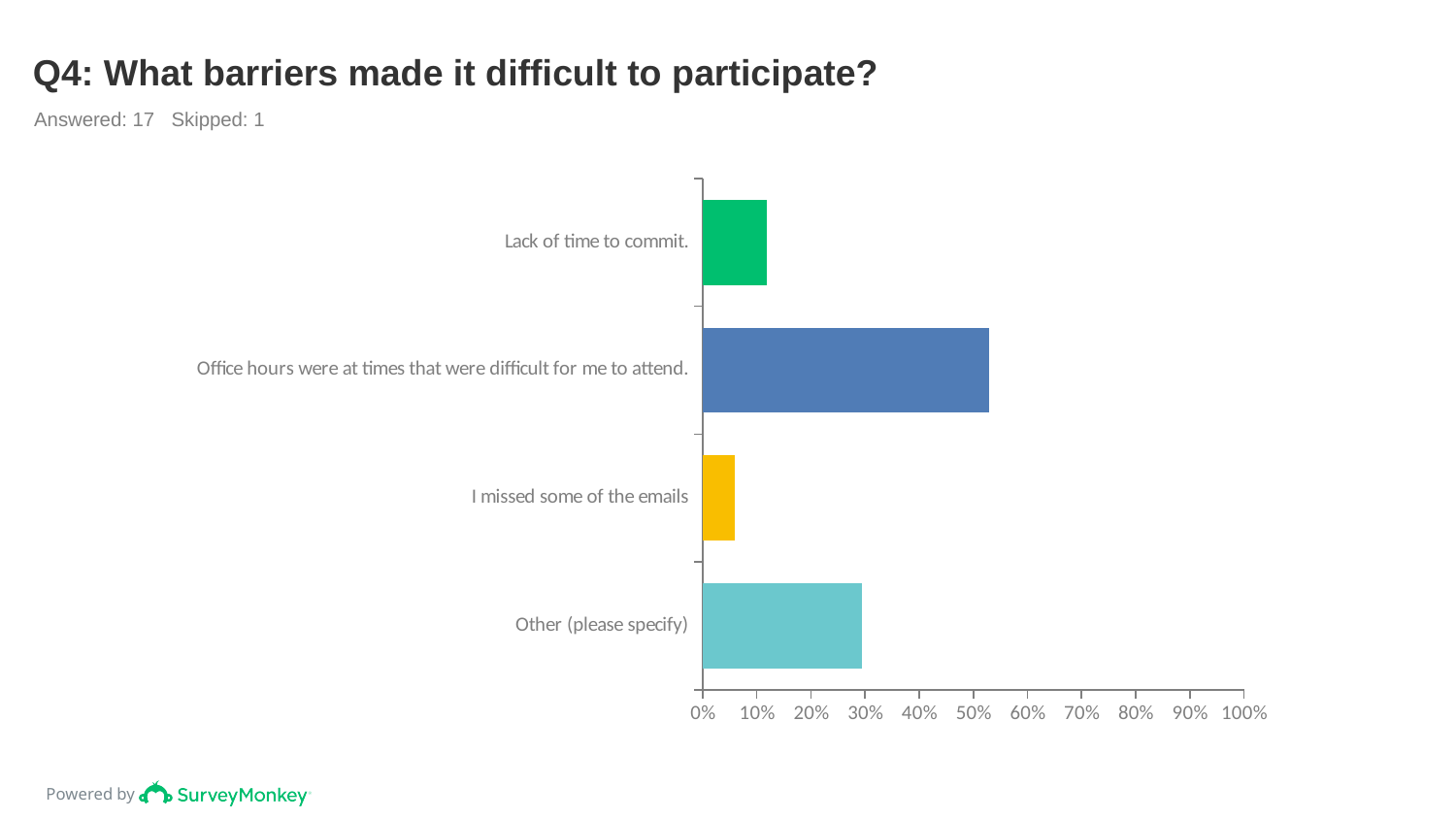
Is the value for "Lack of time to commit." greater or less than 20%? less Is the value for "I missed some of the emails" greater or less than 10%? less Which category has the highest value? Office hours were at times that were difficult for me to attend. What is the title of the chart? Q4: What barriers made it difficult to participate? Which category has the lowest value? I missed some of the emails Which is larger: the value for "Lack of time to commit." or the value for "I missed some of the emails"? Lack of time to commit. How many categories (bars) does the chart show? 4 What kind of chart is shown on the slide? bar chart How many respondents answered the question according to the slide? 17 Which is larger: the value for "Other (please specify)" or the value for "Lack of time to commit."? Other (please specify) Is the value for "Office hours were at times that were difficult for me to attend." greater or less than 50%? greater